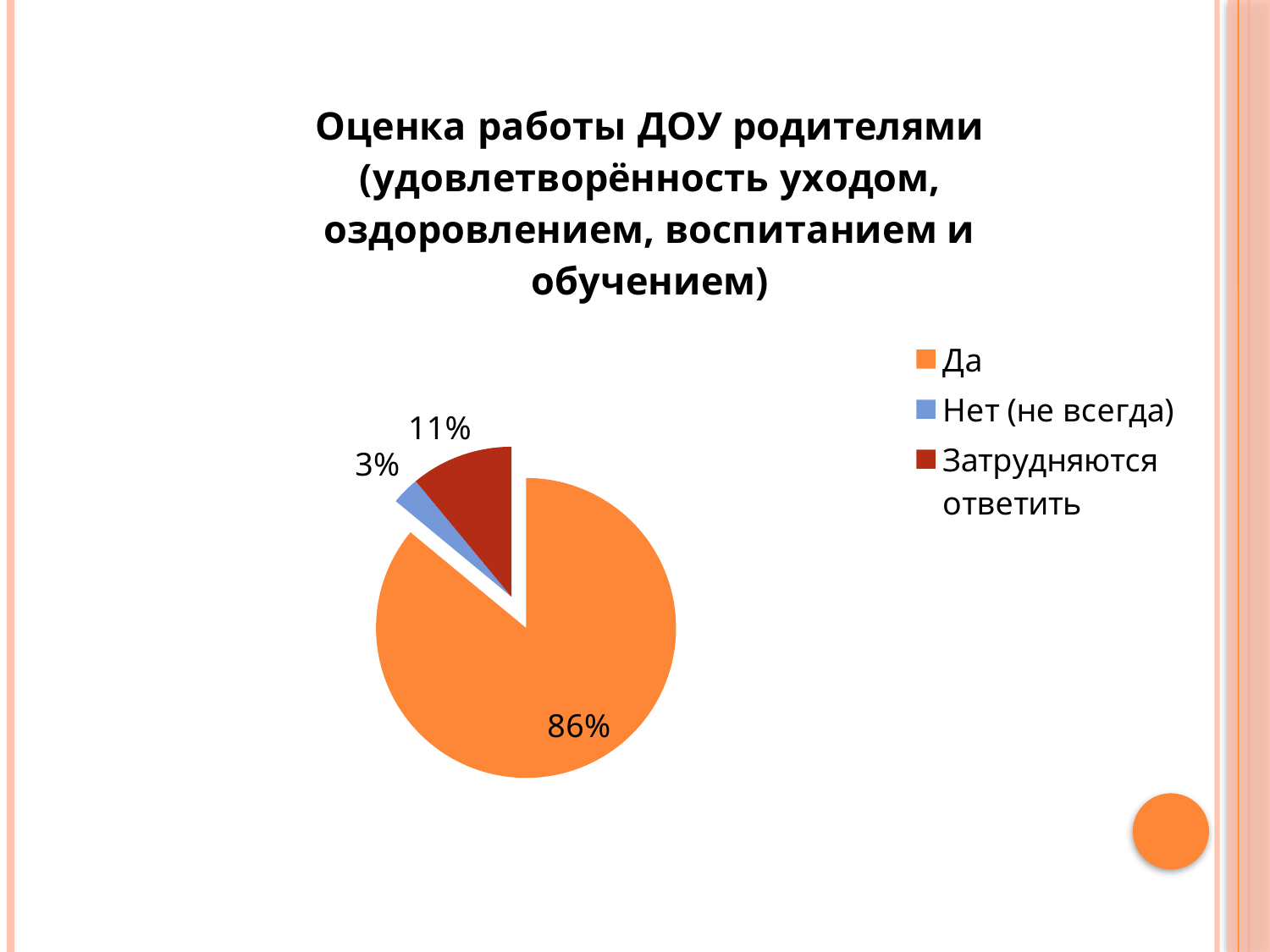
What type of chart is shown on the slide? pie chart Which category has the largest slice of the pie? Да What share of the pie does the "Нет (не всегда)" slice represent? 3% What is the difference in percentage points between the "Да" slice and the "Затрудняются ответить" slice? 75 What share of the pie does the "Да" slice represent? 86% What colour is the "Затрудняются ответить" slice? dark red Which category has the smallest slice of the pie? Нет (не всегда) How many entries does the legend list? 3 Which is larger: the "Затрудняются ответить" slice or the "Нет (не всегда)" slice? Затрудняются ответить How many slices does the pie chart have? 3 What is the difference in percentage points between the "Затрудняются ответить" slice and the "Нет (не всегда)" slice? 8 What share of the pie does the "Затрудняются ответить" slice represent? 11%